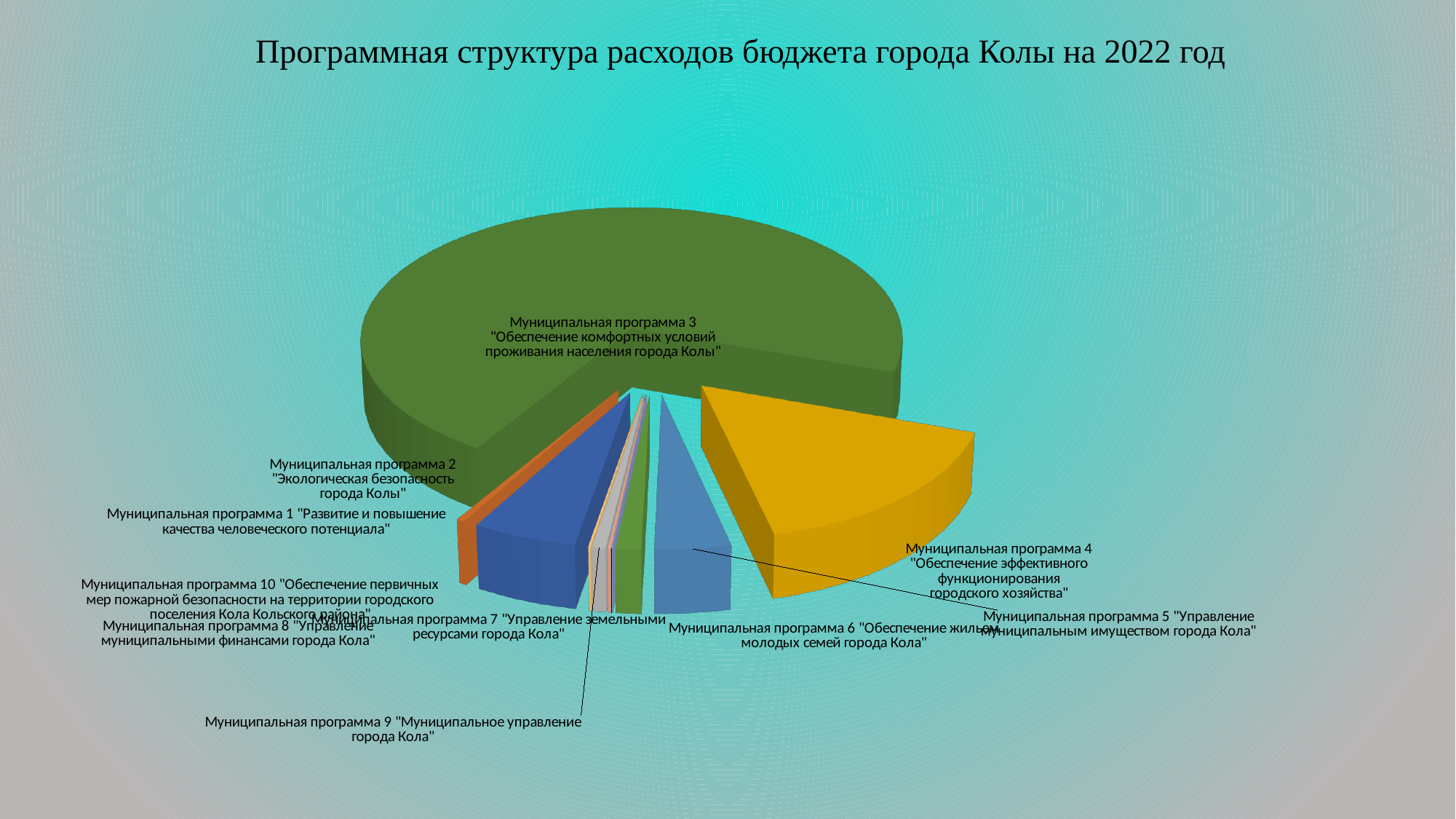
Which slice is larger: Муниципальная программа 1 or Муниципальная программа 2? Муниципальная программа 1 How many municipal programmes (slices) are shown in the pie chart? 10 Which slice is larger: Муниципальная программа 4 or Муниципальная программа 6? Муниципальная программа 4 Which slice is larger: Муниципальная программа 3 or Муниципальная программа 4? Муниципальная программа 3 What is the title of the chart on the slide? Программная структура расходов бюджета города Колы на 2022 год What kind of chart is shown on the slide? pie chart Which municipal programme has the largest share of the pie chart? Муниципальная программа 3 "Обеспечение комфортных условий проживания населения города Колы" What colour is the slice for Муниципальная программа 4 in the pie chart? yellow